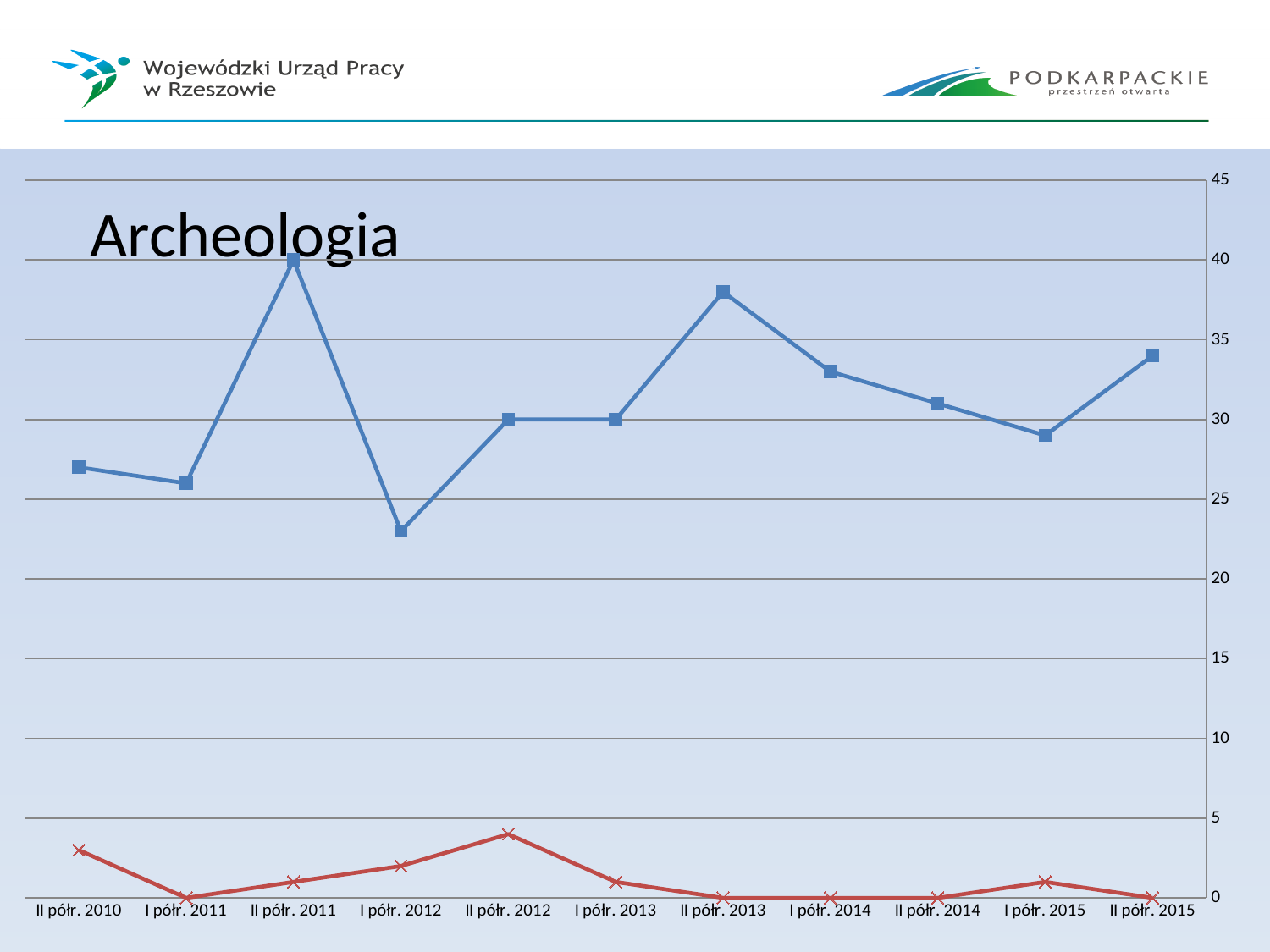
Is the value of the blue line for II półr. 2013 greater or less than 35? greater Which is larger for the blue line: the value for I półr. 2014 or the value for I półr. 2015? I półr. 2014 How many periods are shown along the x axis of the chart? 11 What kind of chart is shown on the slide? line chart Is the value of the blue line for I półr. 2012 greater or less than 25? less In which period does the blue line reach its lowest value? I półr. 2012 What is the value of the blue line for II półr. 2011? 40 What is the title of the chart? Archeologia In which period does the blue line reach its highest value? II półr. 2011 How many lines (data series) are plotted on the chart? 2 What is the value of the red line for I półr. 2014? 0 What is the value of the blue line for II półr. 2012? 30